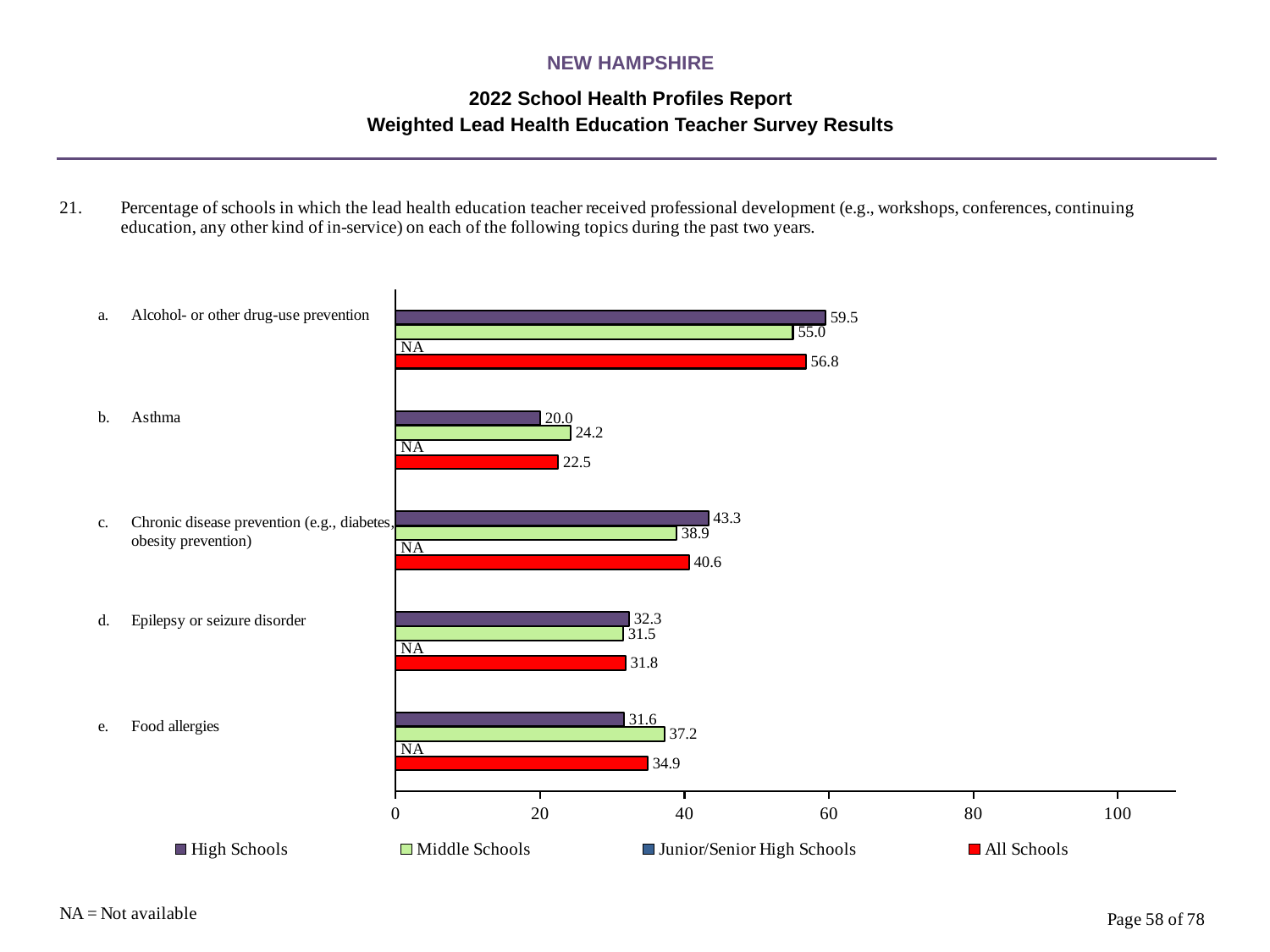
For Food allergies, which is larger: the High Schools value or the Middle Schools value? Middle Schools What is the High Schools value for Alcohol- or other drug-use prevention? 59.5 What kind of chart is shown on the slide? Bar chart Is the All Schools value for Chronic disease prevention greater or less than 40? greater What is the Middle Schools value for Food allergies? 37.2 How many topics are shown on the chart? 5 What is the All Schools value for Epilepsy or seizure disorder? 31.8 What is the All Schools value for Asthma? 22.5 Which topic has the highest All Schools value? Alcohol- or other drug-use prevention What is the difference between the High Schools and Middle Schools values for Chronic disease prevention? 4.4 How many series does the legend list? 4 Which topic has the lowest High Schools value? Asthma